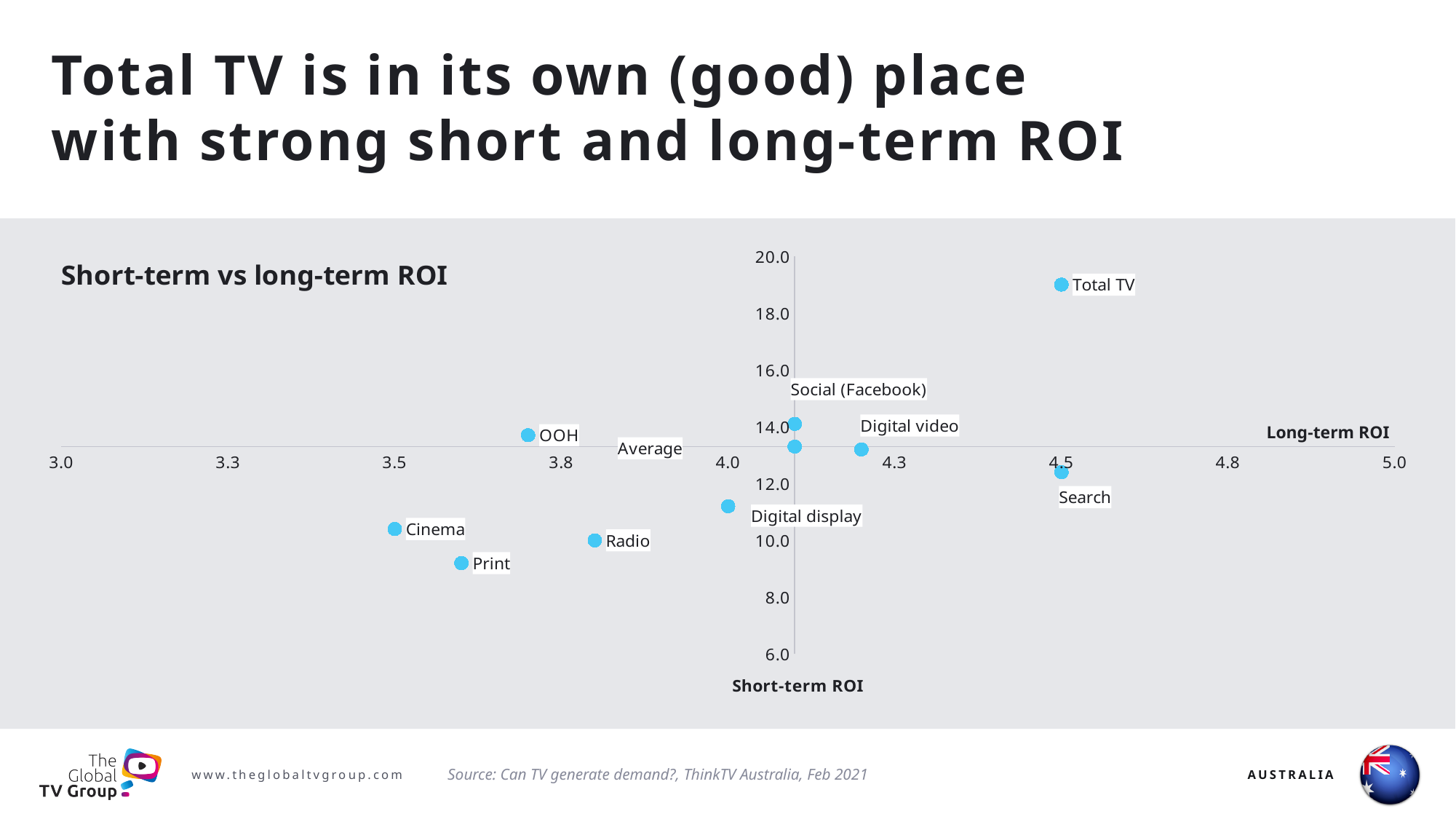
What does the horizontal axis of the chart represent? Long-term ROI Which point has the highest short-term ROI? Total TV Is the long-term ROI for OOH greater or less than 3.8? less Is the short-term ROI for Total TV greater or less than 18.0? greater What is the title of the chart? Short-term vs long-term ROI What kind of chart is shown on the slide? Scatter chart Is the short-term ROI for Print greater or less than 10.0? less How many labelled points are plotted on the chart? 10 Which point has the lowest short-term ROI? Print Which has the higher short-term ROI, Total TV or Search? Total TV Which has the higher long-term ROI, Cinema or Radio? Radio